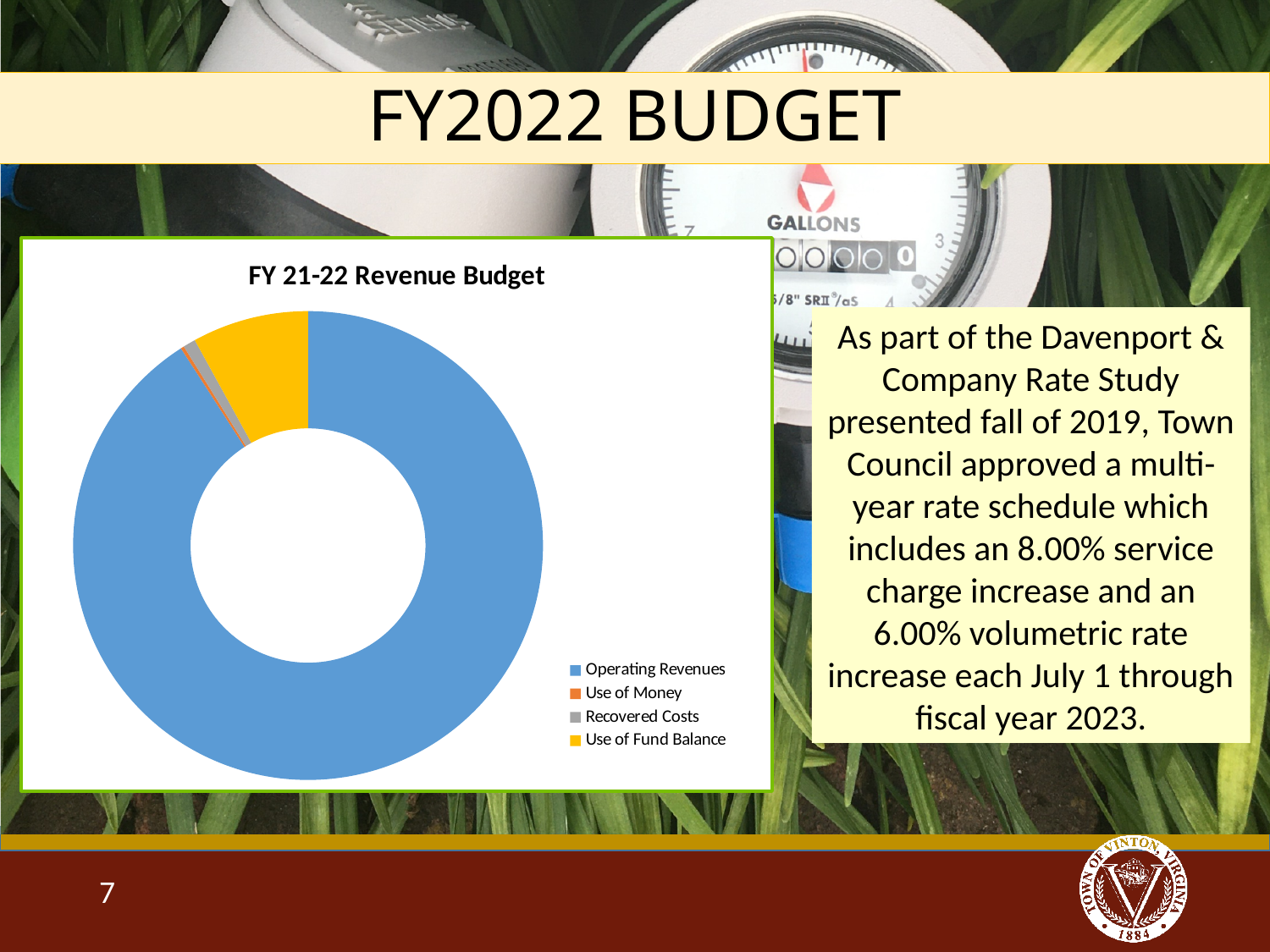
Which category has the largest share of the FY 21-22 Revenue Budget? Operating Revenues What is the title of the chart on the slide? FY 21-22 Revenue Budget Which is larger in the FY 21-22 Revenue Budget chart, Use of Fund Balance or Recovered Costs? Use of Fund Balance What kind of chart is shown on the slide? Doughnut (pie) chart Which is larger in the FY 21-22 Revenue Budget chart, Operating Revenues or Use of Fund Balance? Operating Revenues What colour represents Operating Revenues in the FY 21-22 Revenue Budget chart? Blue Which category is the second largest in the FY 21-22 Revenue Budget chart? Use of Fund Balance How many categories does the FY 21-22 Revenue Budget chart show? 4 Which category in the FY 21-22 Revenue Budget chart is shown in yellow? Use of Fund Balance